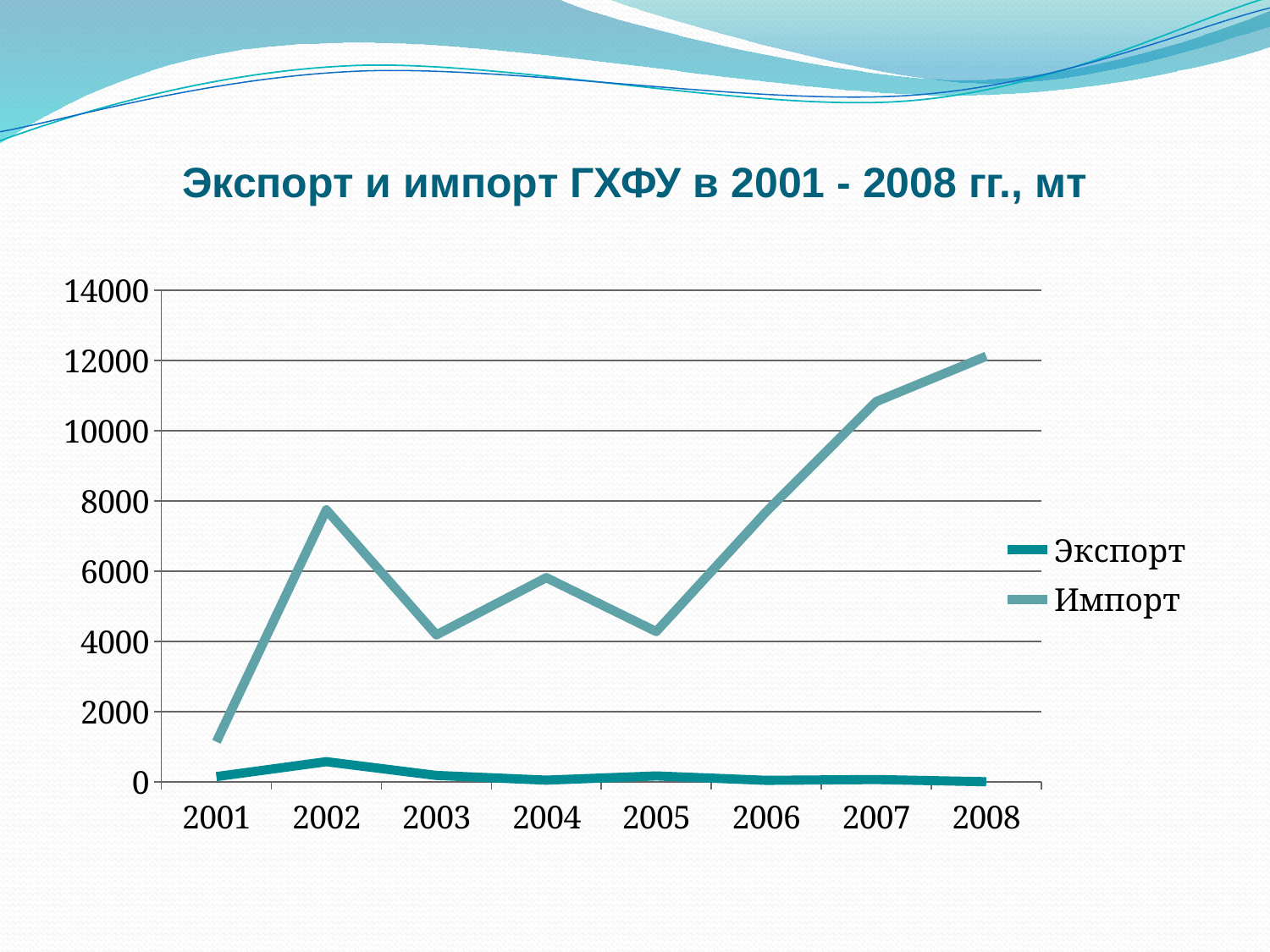
In which year is the value for Импорт lowest? 2001 What kind of chart is shown on the slide? line chart What is the title of the chart? Экспорт и импорт ГХФУ в 2001 - 2008 гг., мт Which is larger, the value for Импорт in 2004 or in 2005? 2004 Is the value for Импорт in 2001 greater or less than 2000? less Does the value for Импорт rise or fall from 2005 to 2008? rise Is the value for Импорт in 2008 greater or less than 10000? greater In which year is the value for Экспорт highest? 2002 How many series does the legend list? 2 How many years are shown on the x axis? 8 Is the value for Импорт in 2002 greater or less than 6000? greater In which year is the value for Импорт highest? 2008